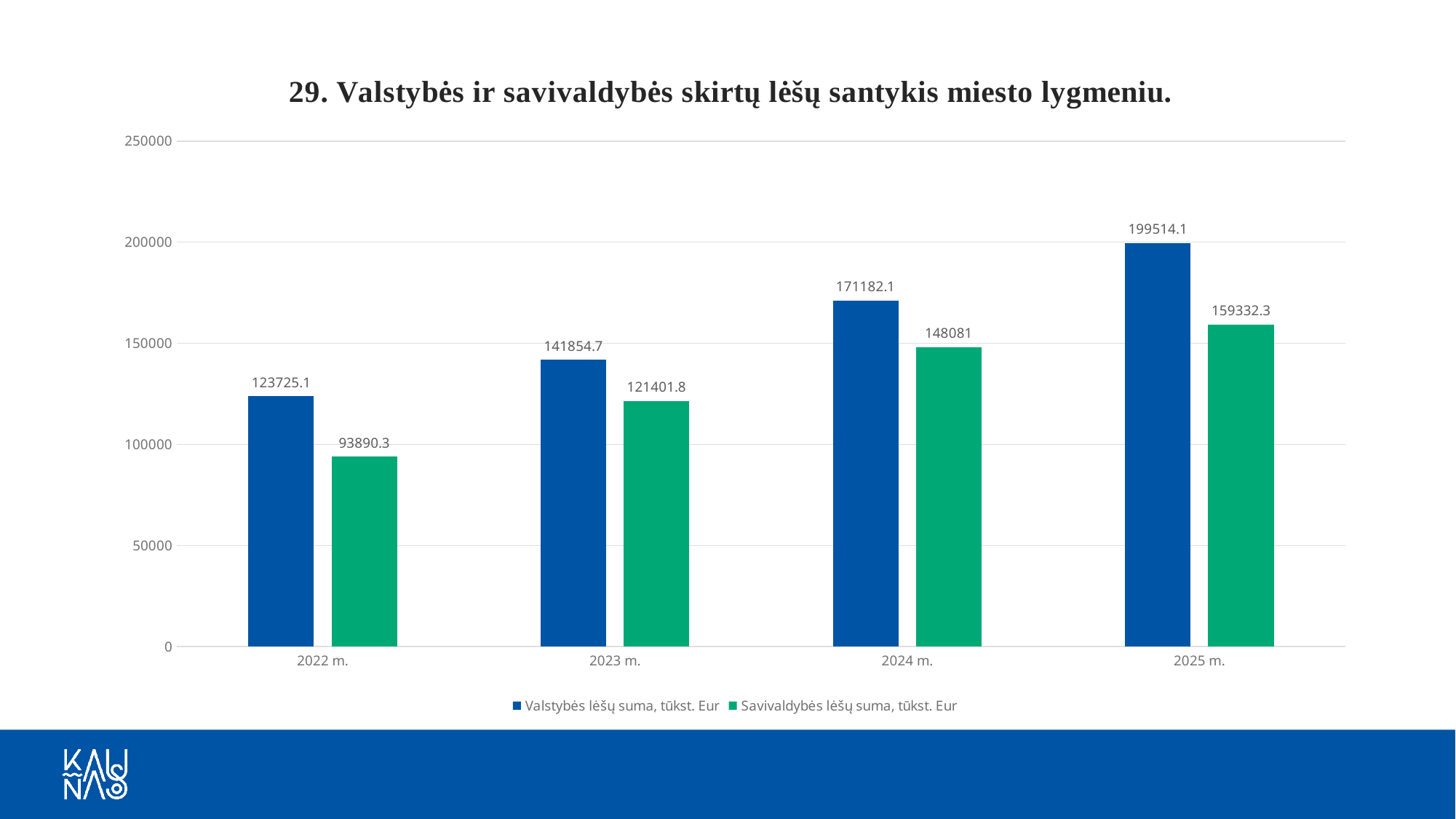
What is the difference between Valstybės lėšų suma and Savivaldybės lėšų suma in 2025 m.? 40181.8 How many series does the legend list? 2 Is the value of Savivaldybės lėšų suma, tūkst. Eur for 2022 m. greater or less than 100000? less What kind of chart is shown on the slide? Bar chart By how much did Valstybės lėšų suma, tūkst. Eur increase from 2022 m. to 2025 m.? 75789 Which is larger in 2023 m.: Valstybės lėšų suma or Savivaldybės lėšų suma? Valstybės lėšų suma How many years are shown on the x axis? 4 In which year is Valstybės lėšų suma, tūkst. Eur the highest? 2025 m. In which year is Savivaldybės lėšų suma, tūkst. Eur the lowest? 2022 m. What is the value of Valstybės lėšų suma, tūkst. Eur for 2022 m.? 123725.1 What is the value of Savivaldybės lėšų suma, tūkst. Eur for 2024 m.? 148081 What is the value of Savivaldybės lėšų suma, tūkst. Eur for 2025 m.? 159332.3